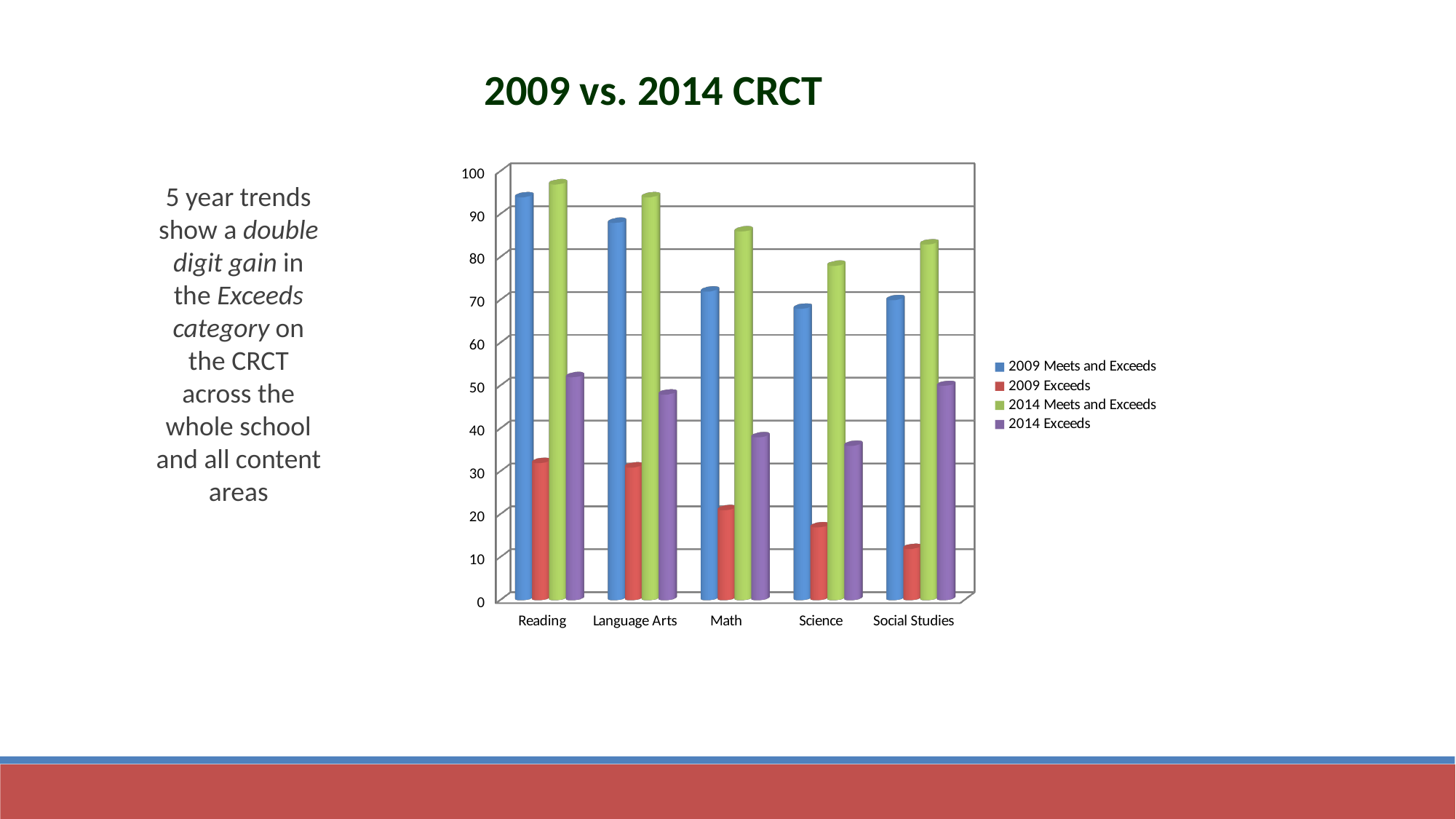
Which is larger, the 2014 Exceeds value for Reading or for Math? Reading What kind of chart is shown on the slide? bar chart What colour are the bars for the 2014 Exceeds series? purple Which is larger, the 2009 Meets and Exceeds value for Language Arts or for Science? Language Arts Which content area has the highest 2014 Meets and Exceeds value? Reading Is the 2014 Meets and Exceeds value for Science greater or less than 70? greater Is the 2009 Exceeds value for Math greater or less than 30? less Is the 2009 Meets and Exceeds value for Reading greater or less than 90? greater How many content areas are shown on the x axis of the chart? 5 How many series does the chart's legend list? 4 Which content area has the lowest 2009 Exceeds value? Social Studies What is the title of the slide containing the chart? 2009 vs. 2014 CRCT